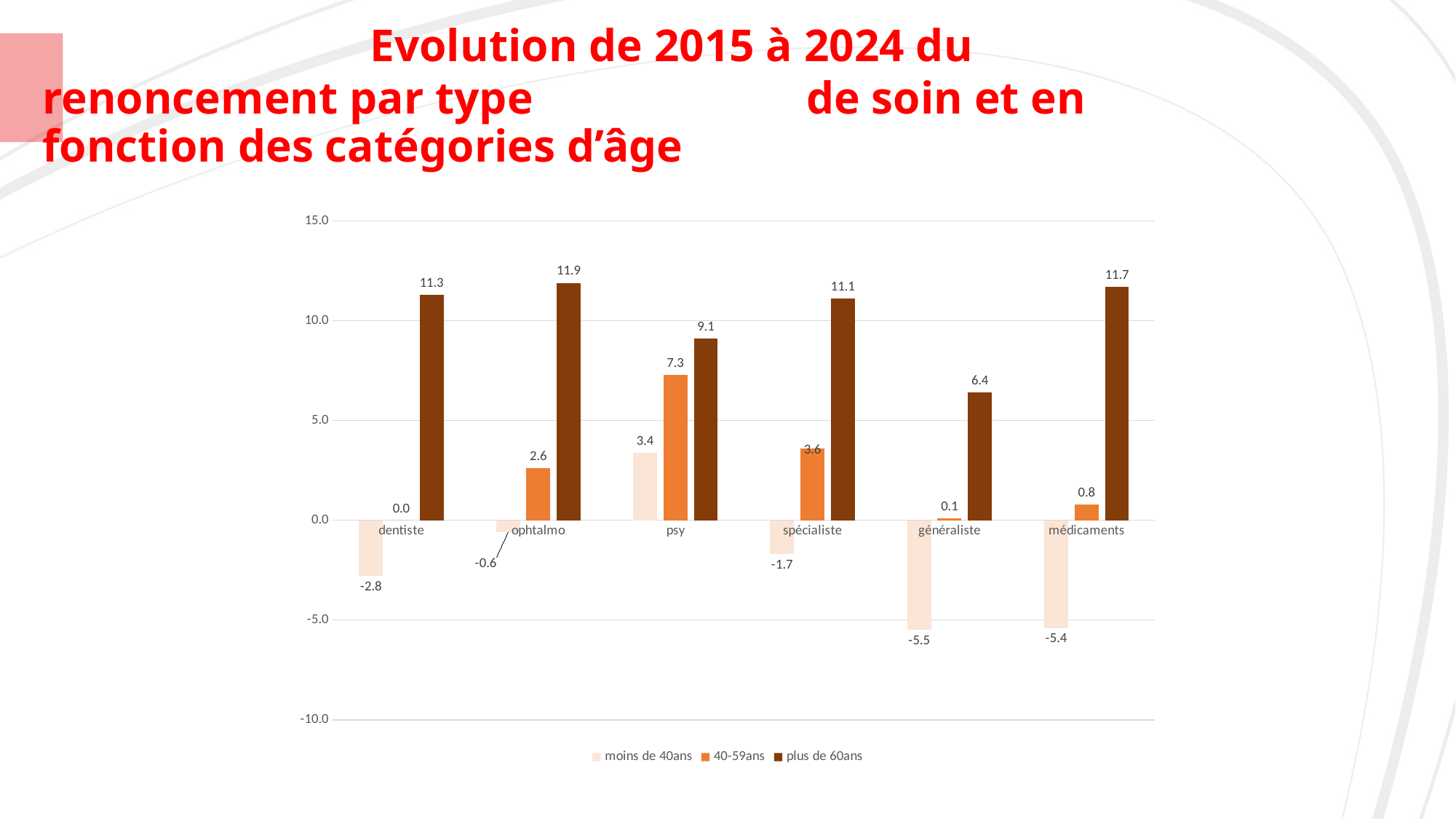
How many series does the legend list? 3 What is the difference between the 'plus de 60ans' and '40-59ans' values for 'dentiste'? 11.3 Is the 'plus de 60ans' value for 'psy' greater or less than 10.0? less What is the value for '40-59ans' in the 'psy' category? 7.3 What kind of chart is shown on the slide? bar chart Which category has the highest value for the 'plus de 60ans' series? ophtalmo Which category has the lowest value for the 'plus de 60ans' series? généraliste What is the value for 'plus de 60ans' in the 'ophtalmo' category? 11.9 Which category has the highest value for the 'moins de 40ans' series? psy What is the value for 'moins de 40ans' in the 'généraliste' category? -5.5 How many categories are shown on the x axis? 6 Which is larger: the '40-59ans' value for 'spécialiste' or for 'ophtalmo'? spécialiste